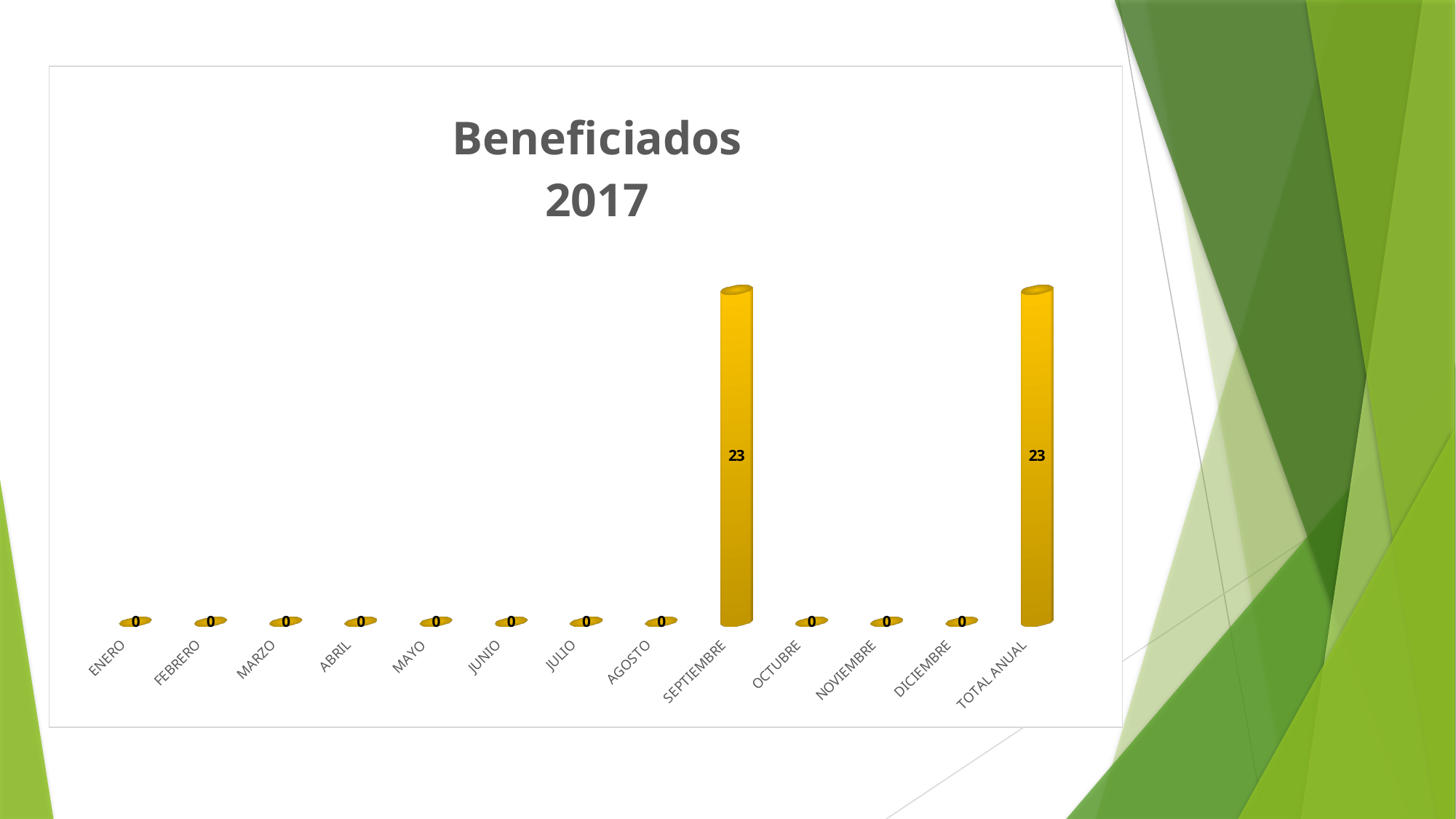
What kind of chart is this? bar chart Which is larger, the value for SEPTIEMBRE or the value for OCTUBRE? SEPTIEMBRE How many categories are shown on the x axis? 13 What is the value for TOTAL ANUAL? 23 What is the value for SEPTIEMBRE? 23 What is the value for ENERO? 0 What colour are the bars in the chart? yellow/gold Which month has the highest value? SEPTIEMBRE What is the value for DICIEMBRE? 0 How many months have a value of 0? 11 What is the title of the chart? Beneficiados 2017 What is the difference between the values for SEPTIEMBRE and AGOSTO? 23